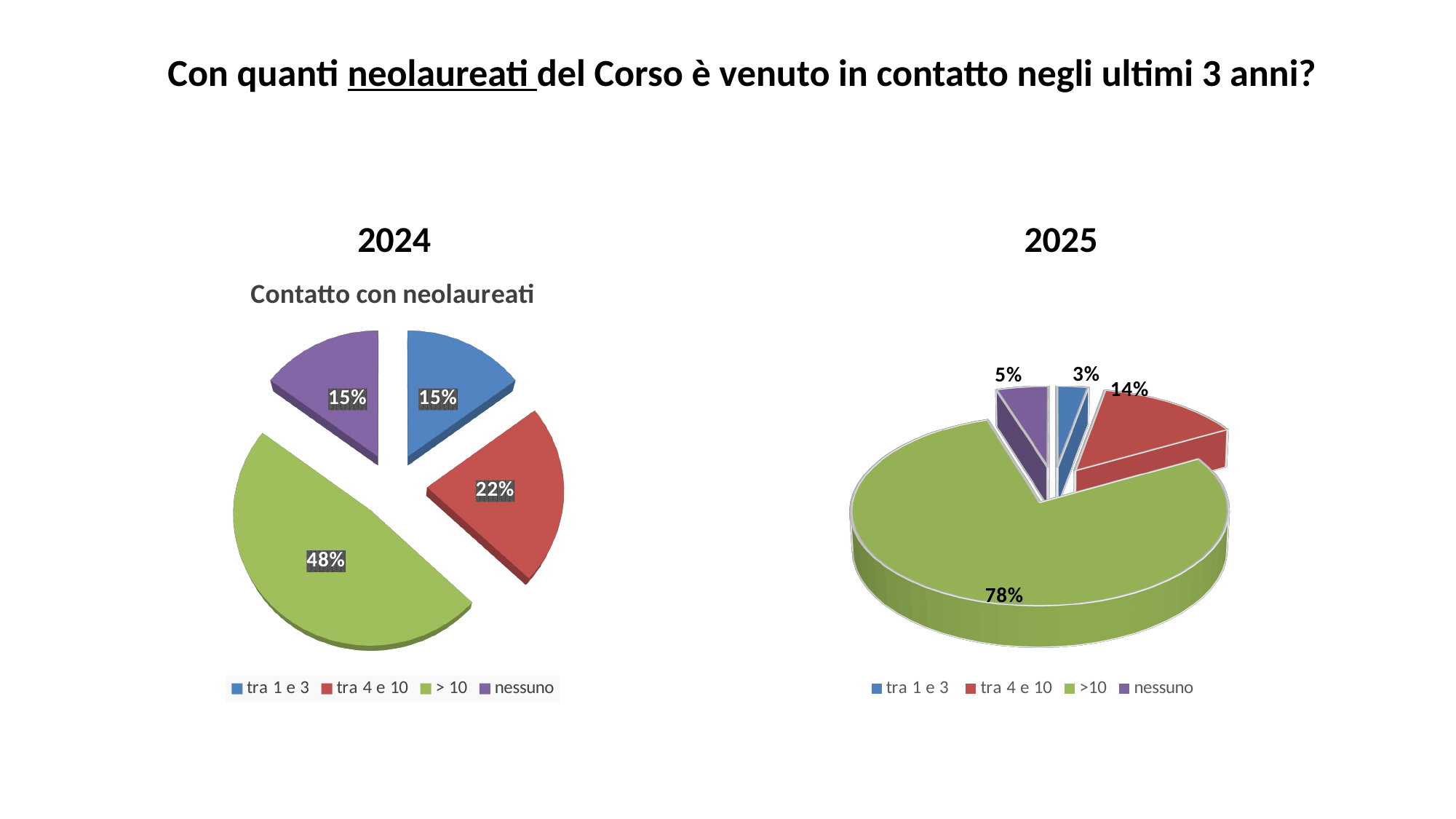
What is the difference between the '>10' share in 2025 and the '> 10' share in 2024? 30 percentage points How many categories does the 2024 pie chart have? 4 In the 2024 pie chart, what percentage is shown for 'tra 4 e 10'? 22% In the 2024 pie chart, what percentage is shown for '> 10'? 48% What is the title shown above the 2024 pie chart? Contatto con neolaureati In the 2025 pie chart, what percentage is shown for 'tra 1 e 3'? 3% In the 2025 pie chart, which is larger: 'tra 4 e 10' or 'nessuno'? tra 4 e 10 In the 2025 pie chart, what percentage is shown for 'nessuno'? 5% What type of chart is used for the 2025 data? Pie chart In the 2024 pie chart, which category has the largest share? > 10 In the 2025 pie chart, which category has the smallest share? tra 1 e 3 In the 2025 pie chart, what percentage is shown for '>10'? 78%